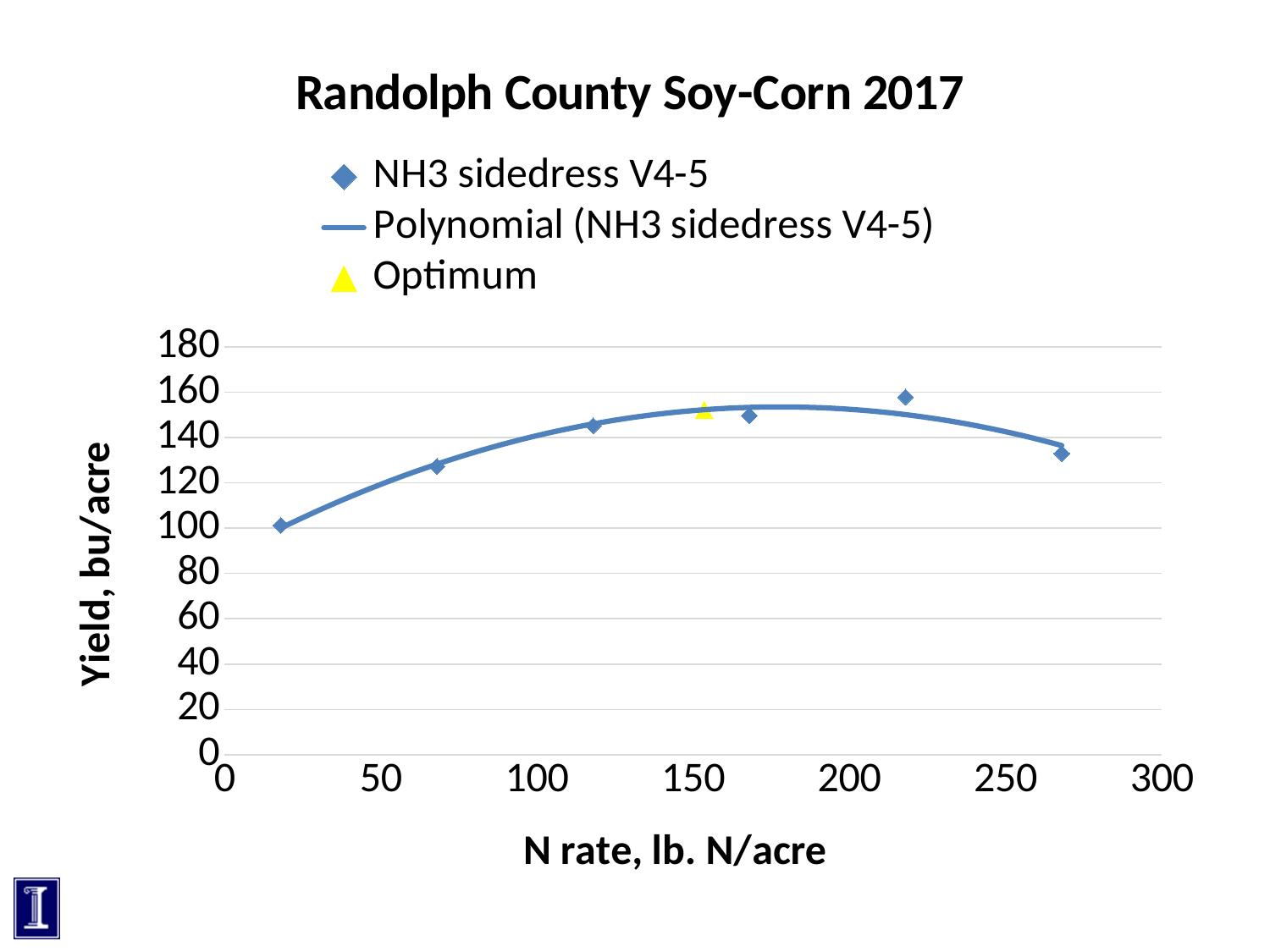
What is the title of the chart? Randolph County Soy-Corn 2017 Which has the higher yield: the NH3 sidedress V4-5 point near an N rate of 118 or the one near 268? the one near 118 What is the label of the y axis? Yield, bu/acre Does the polynomial curve rise or fall as the N rate increases from 200 to 250? fall What kind of chart is shown on the slide? scatter chart with a polynomial trendline Which NH3 sidedress V4-5 data point has the highest yield: the one near an N rate of 218 or the one near 168? the one near 218 Is the yield for the NH3 sidedress V4-5 point near an N rate of 68 greater or less than 120? greater How many NH3 sidedress V4-5 data points (diamonds) are plotted? 6 Is the yield for the NH3 sidedress V4-5 point near an N rate of 268 greater or less than 140? less How many entries does the legend list? 3 Is the yield at the Optimum marker greater or less than 140? greater